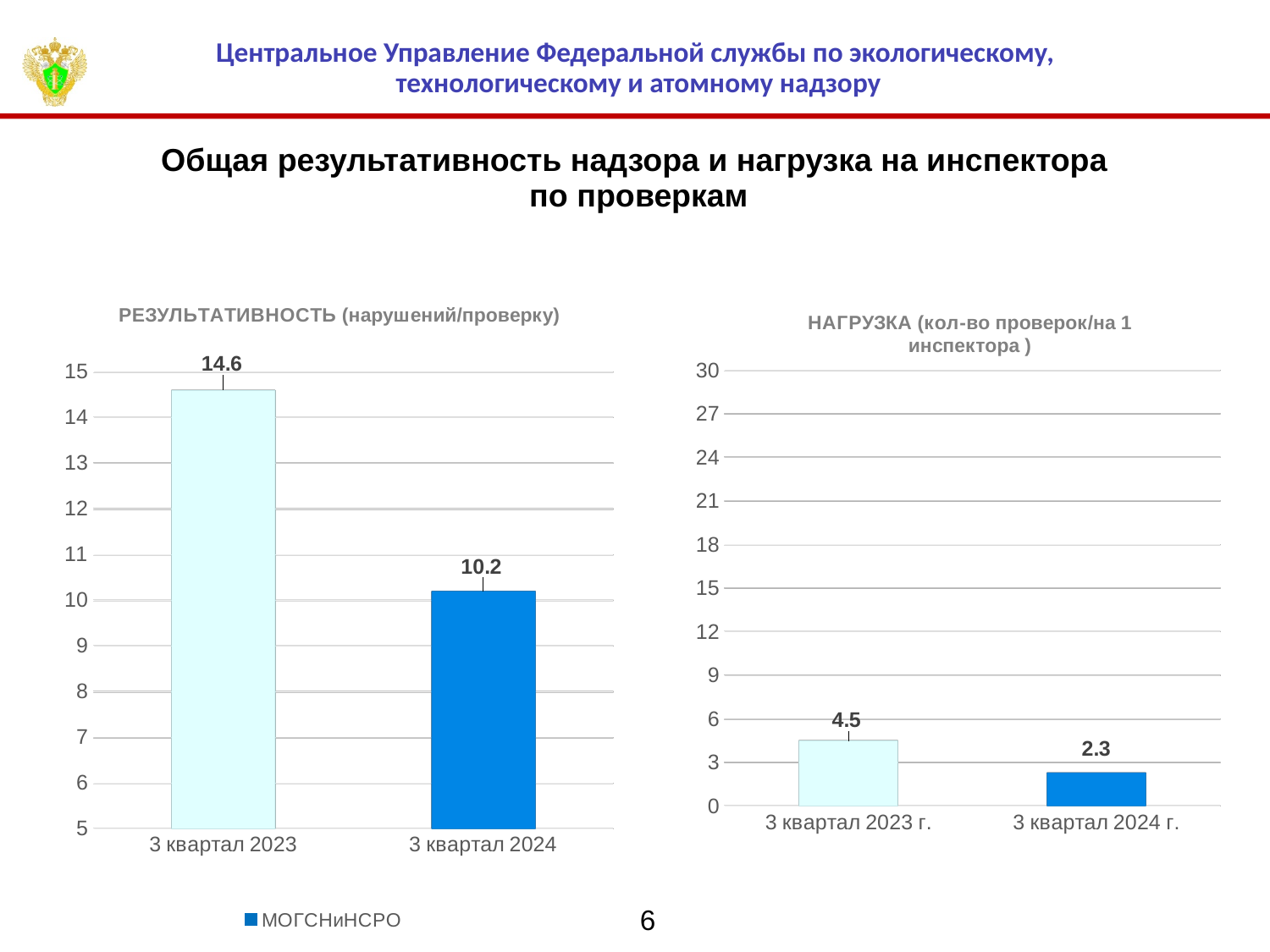
What kind of chart is the НАГРУЗКА chart? bar chart In the РЕЗУЛЬТАТИВНОСТЬ chart, what is the value for 3 квартал 2024? 10.2 In the НАГРУЗКА chart, which category has the lowest value? 3 квартал 2024 г. In the НАГРУЗКА chart, what is the value for 3 квартал 2023 г.? 4.5 In the НАГРУЗКА chart, is the value for 3 квартал 2023 г. greater or less than 6? less How many categories does the РЕЗУЛЬТАТИВНОСТЬ chart show? 2 In the НАГРУЗКА chart, what is the value for 3 квартал 2024 г.? 2.3 In the РЕЗУЛЬТАТИВНОСТЬ chart, which category has the highest value? 3 квартал 2023 In the РЕЗУЛЬТАТИВНОСТЬ chart, what is the difference between the values for 3 квартал 2023 and 3 квартал 2024? 4.4 In the РЕЗУЛЬТАТИВНОСТЬ chart, what is the value for 3 квартал 2023? 14.6 In the НАГРУЗКА chart, what is the difference between the values for 3 квартал 2023 г. and 3 квартал 2024 г.? 2.2 In the РЕЗУЛЬТАТИВНОСТЬ chart, do the values rise or fall from 3 квартал 2023 to 3 квартал 2024? fall